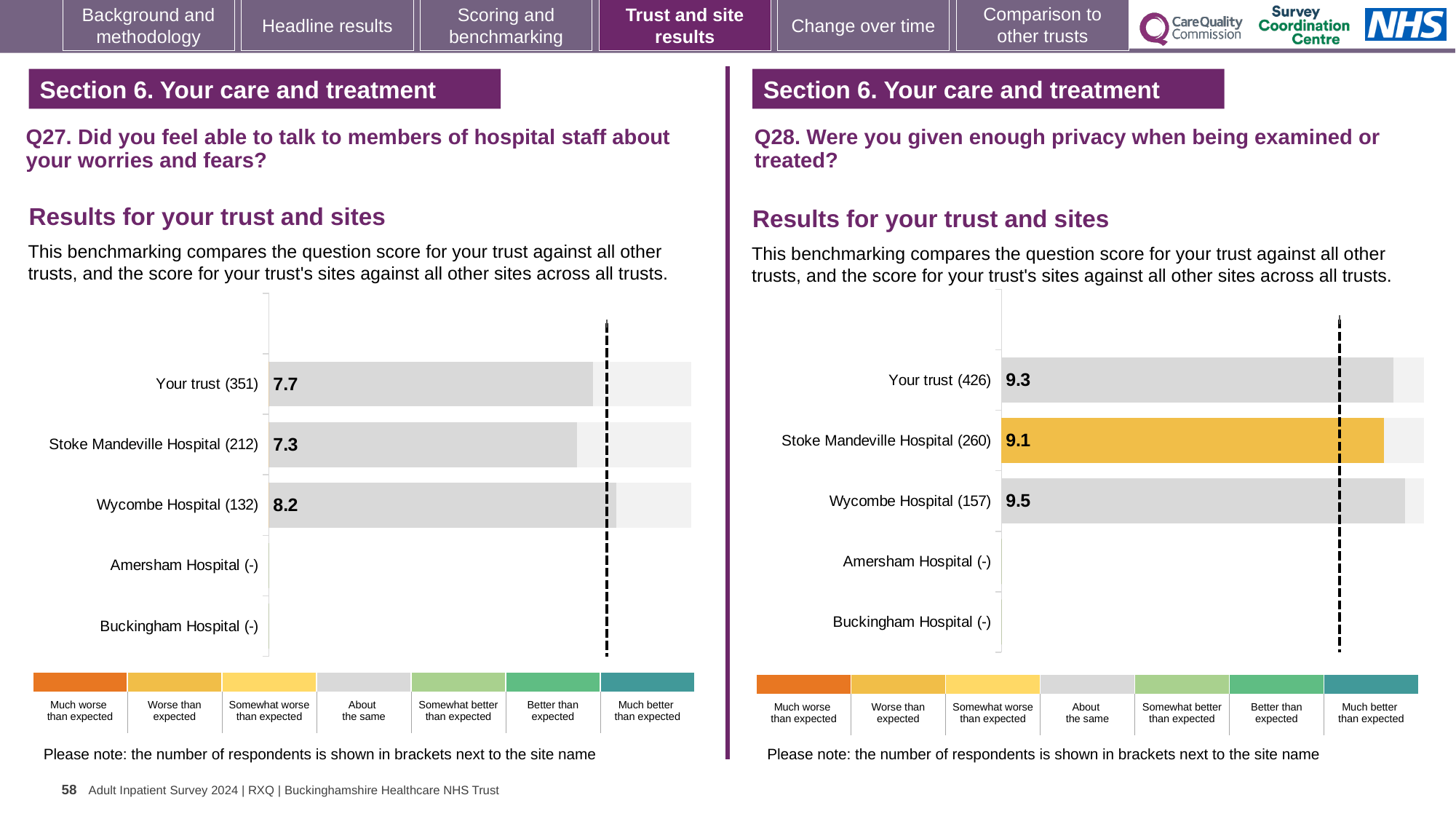
In the Q28 chart on the right, which site's bar is coloured yellow (somewhat worse than expected)? Stoke Mandeville Hospital In the Q27 chart on the left, what is the difference between the scores for Wycombe Hospital and Stoke Mandeville Hospital? 0.9 In the Q28 chart on the right, what is the difference between the scores for Your trust and Stoke Mandeville Hospital? 0.2 In the Q27 chart on the left, what is the score for Wycombe Hospital? 8.2 In the Q27 chart on the left, which site has the lowest score? Stoke Mandeville Hospital In the Q28 chart on the right, which site has the highest score? Wycombe Hospital In the Q27 chart on the left, how many respondents are shown for Stoke Mandeville Hospital? 212 In the Q28 chart on the right, is the score for Your trust larger or smaller than the score for Wycombe Hospital? smaller What type of chart is used for the Q27 results on the left? bar chart In the Q28 chart on the right, what is the score for Stoke Mandeville Hospital? 9.1 In the Q27 chart on the left, what is the score for Your trust? 7.7 In the Q28 chart on the right, how many respondents are shown for Your trust? 426